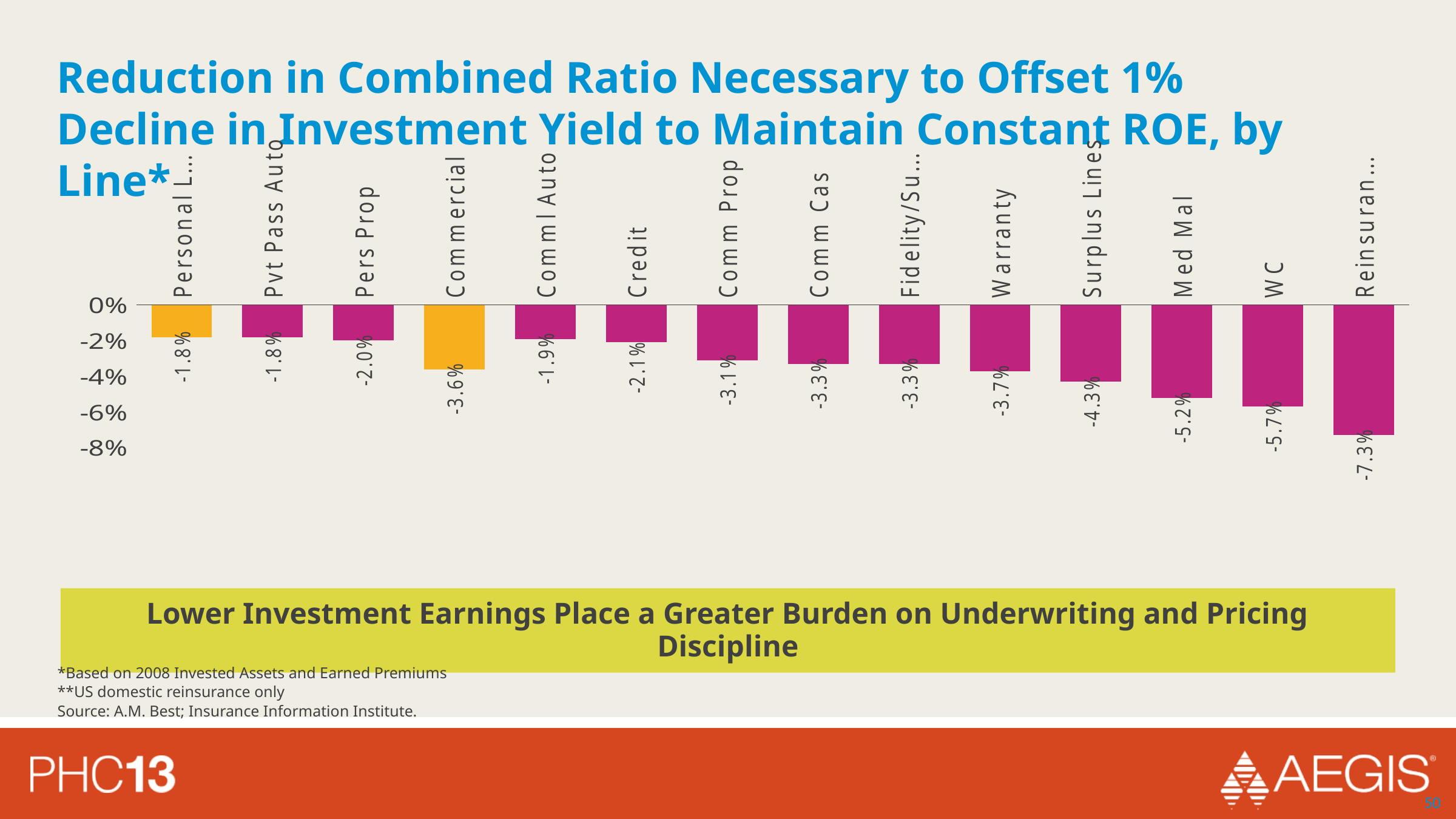
Is the value for Med Mal greater or less than -4%? less What kind of chart is shown on the slide? bar chart What is the difference between the values for Surplus Lines and Pers Prop? 2.3 percentage points What is the value for WC? -5.7% What is the value for Credit? -2.1% What is the value for Med Mal? -5.2% What is the value for Surplus Lines? -4.3% What is the difference between the values for WC and Med Mal? 0.5 percentage points Which has the lower value, Warranty or Comm Cas? Warranty What is the value for Comm Prop? -3.1% What is the value for Commercial? -3.6% How many bars are shown in the chart? 14